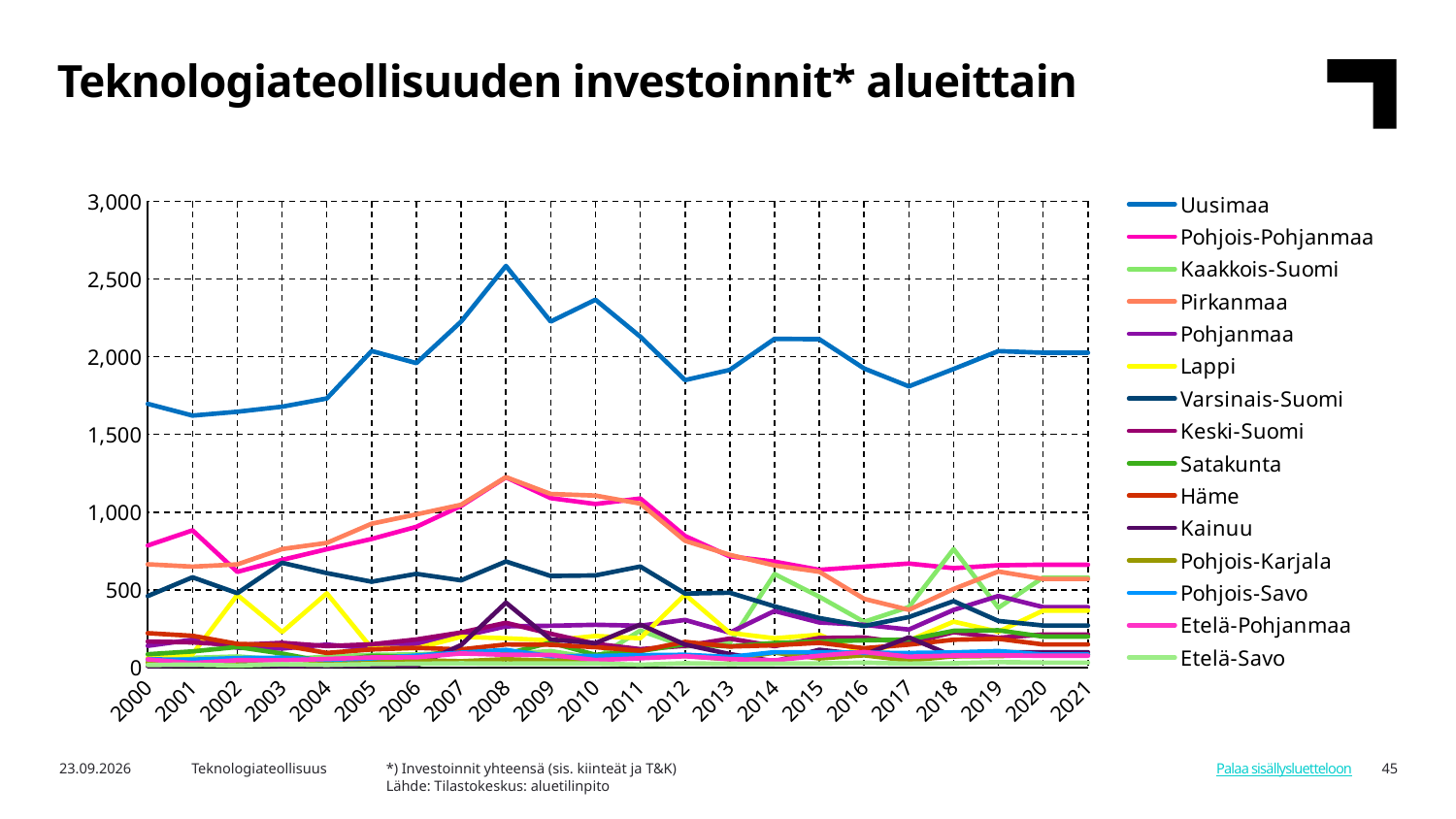
What is the title of the chart on the slide? Teknologiateollisuuden investoinnit* alueittain Does the Uusimaa line rise or fall between 2004 and 2008? rise In which year does the Uusimaa line reach its peak? 2008 How many years are plotted along the x axis? 22 Is the value for Uusimaa in 2008 greater or less than 2,500? greater Is the value for Uusimaa in 2017 greater or less than 2,000? less Which is larger in 2010, the value for Uusimaa or the value for Pohjois-Pohjanmaa? Uusimaa Is the value for Pirkanmaa in 2008 greater or less than 1,000? greater Which region has the highest investment values across the whole period? Uusimaa What kind of chart is shown on the slide? line chart How many series does the legend list? 15